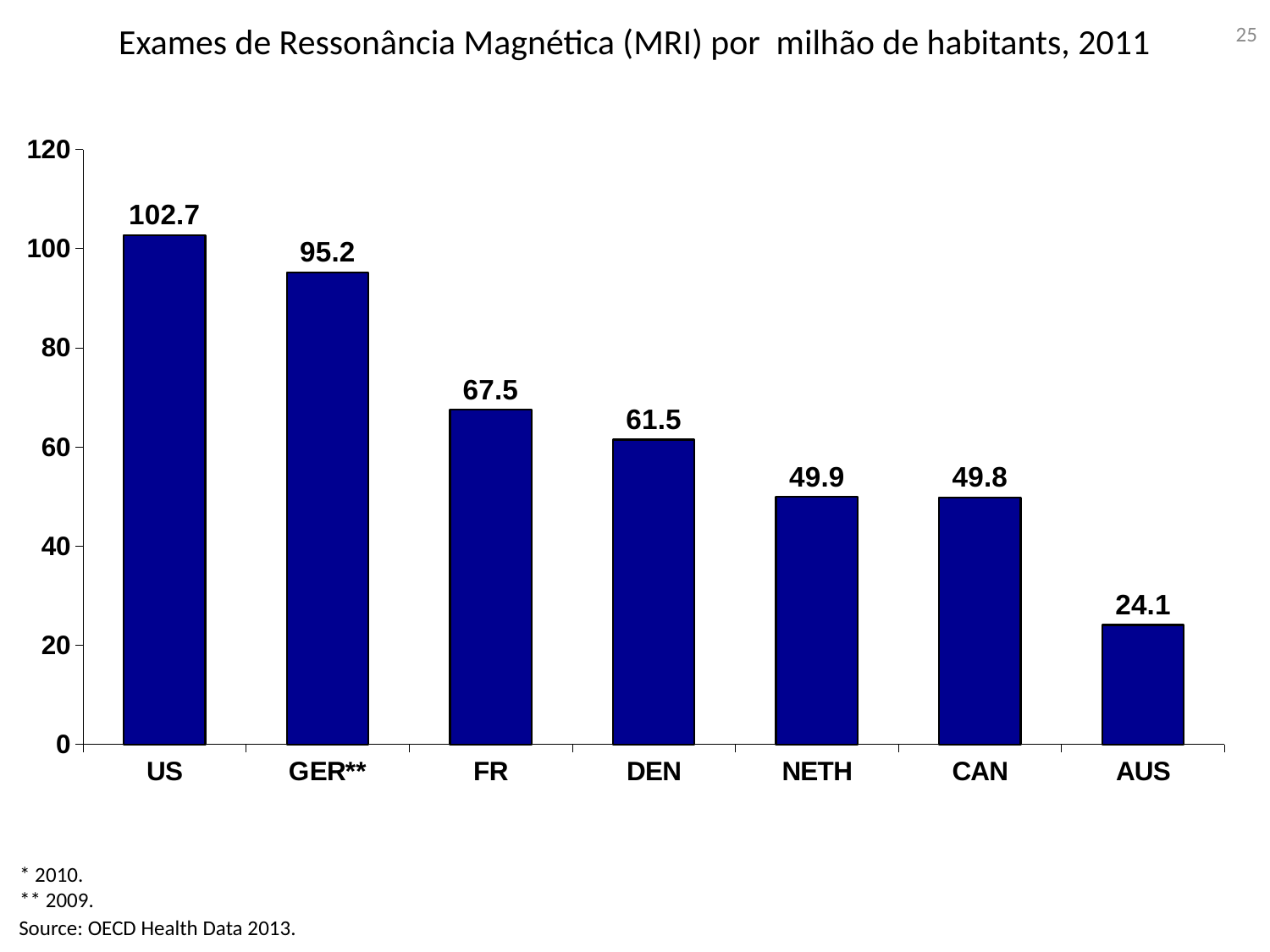
What is the difference between the values for FR and DEN? 6 What is the difference between the values for US and GER**? 7.5 What is the value for FR? 67.5 What is the value for US? 102.7 What kind of chart is this? bar chart What is the value for AUS? 24.1 Which category has the highest value? US Which is larger, the value for DEN or the value for AUS? DEN Which category has the lowest value? AUS What is the value for GER**? 95.2 Do the values rise or fall from left to right along the x axis? fall How many categories are shown on the x axis? 7